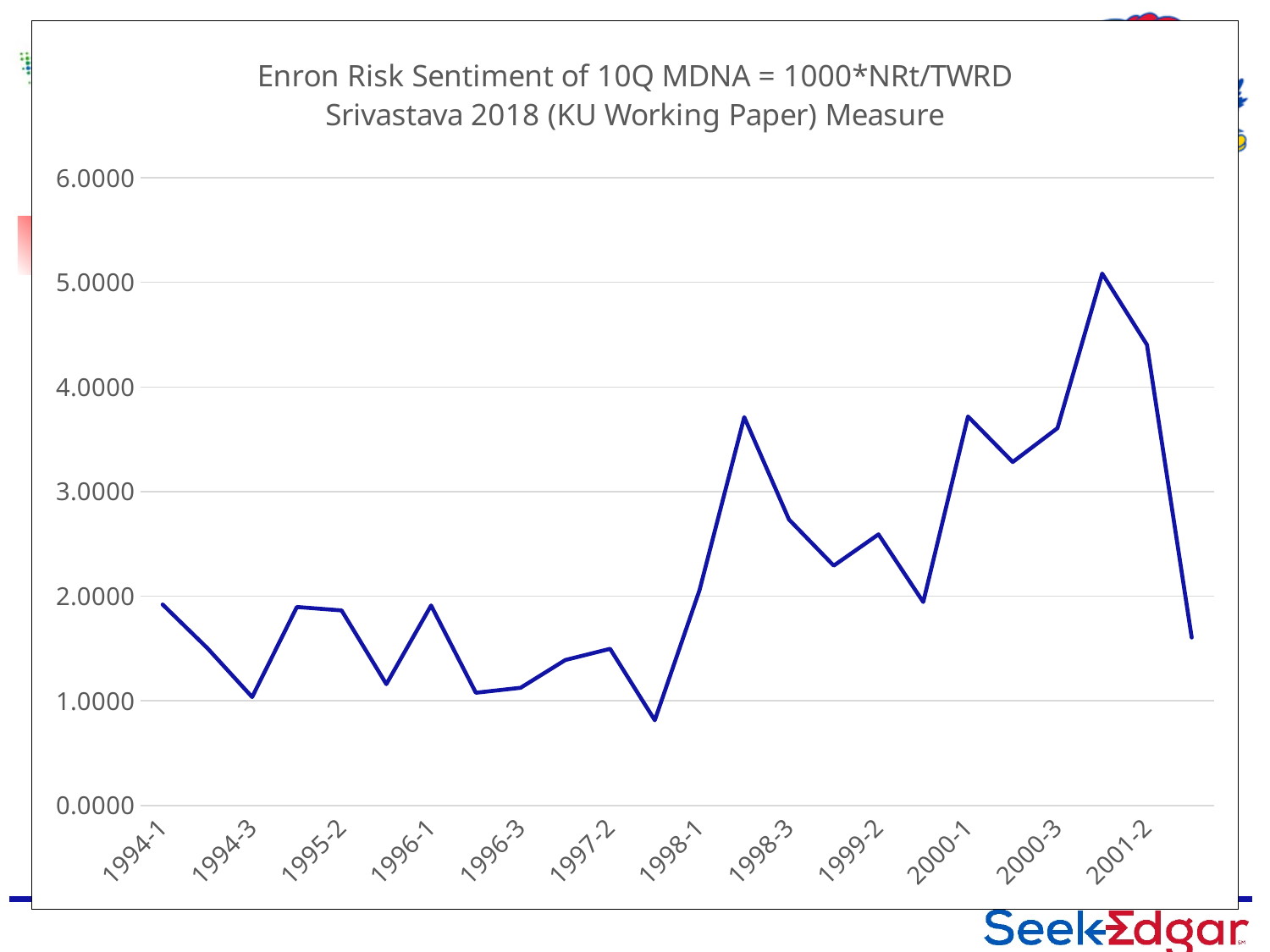
Is the lowest value on the chart greater or less than 1.0000? less Is the value for 2001-2 greater or less than 4.0000? greater Is the value for 2000-1 greater or less than 3.0000? greater How many lines (series) are plotted on the chart? 1 What kind of chart is shown on the slide? line chart Does the line rise or fall between 2001-2 and the final point on the chart? fall Which has the larger value, 2001-2 or 1998-3? 2001-2 Which has the larger value, 2000-1 or 1994-1? 2000-1 What is the title of the chart? Enron Risk Sentiment of 10Q MDNA = 1000*NRt/TWRD Srivastava 2018 (KU Working Paper) Measure